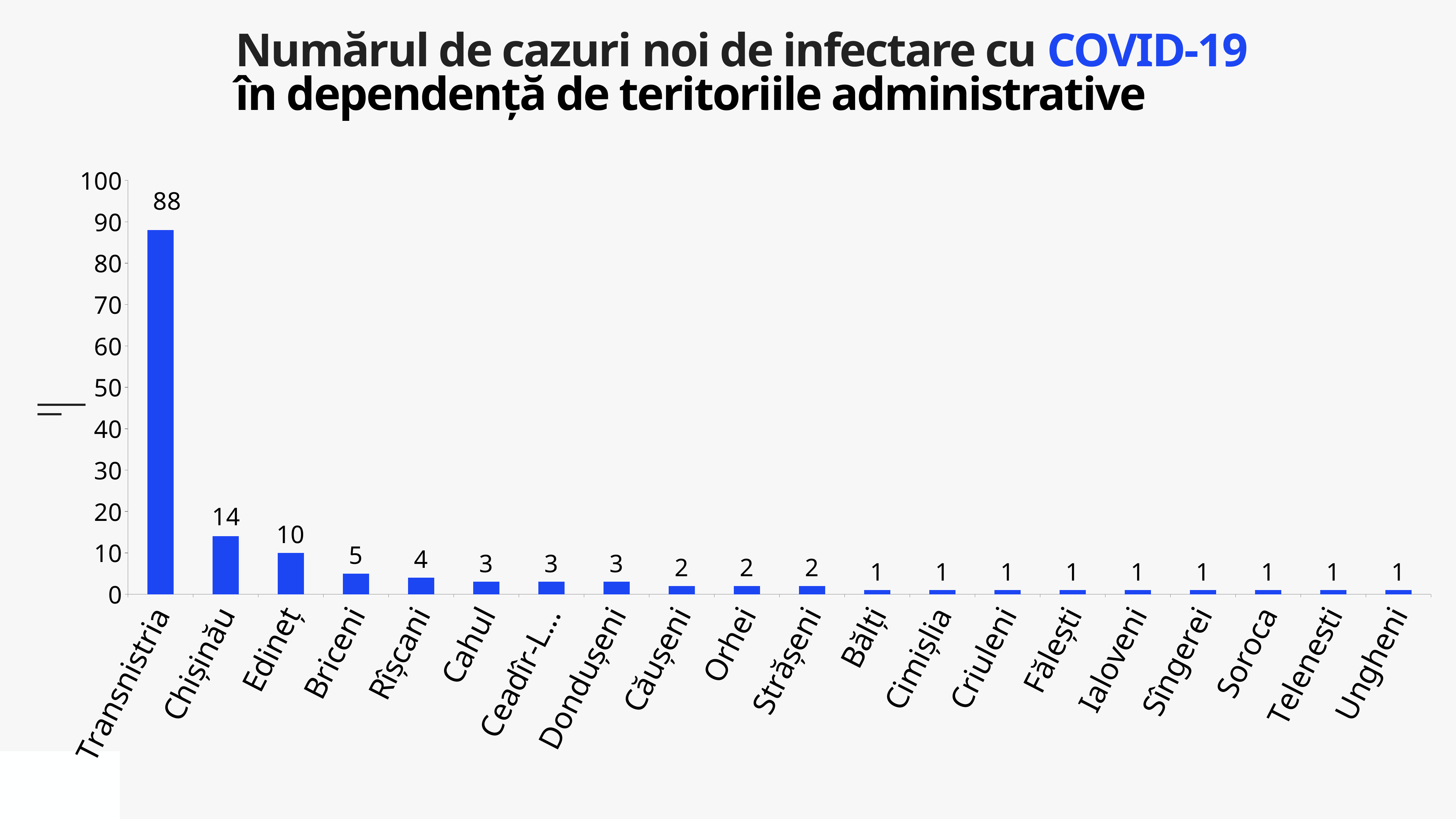
What is the difference between the values for Transnistria and Chișinău? 74 What is the difference between the values for Edineț and Rîșcani? 6 What is the value for Transnistria? 88 Is the value for Transnistria greater or less than 80? greater Which category has the highest value? Transnistria What is the value for Briceni? 5 What is the value for Edineț? 10 What is the value for Orhei? 2 What is the value for Chișinău? 14 How many categories are shown on the x axis? 20 Which is larger, the value for Cahul or the value for Bălți? Cahul What kind of chart is shown on the slide? Bar chart